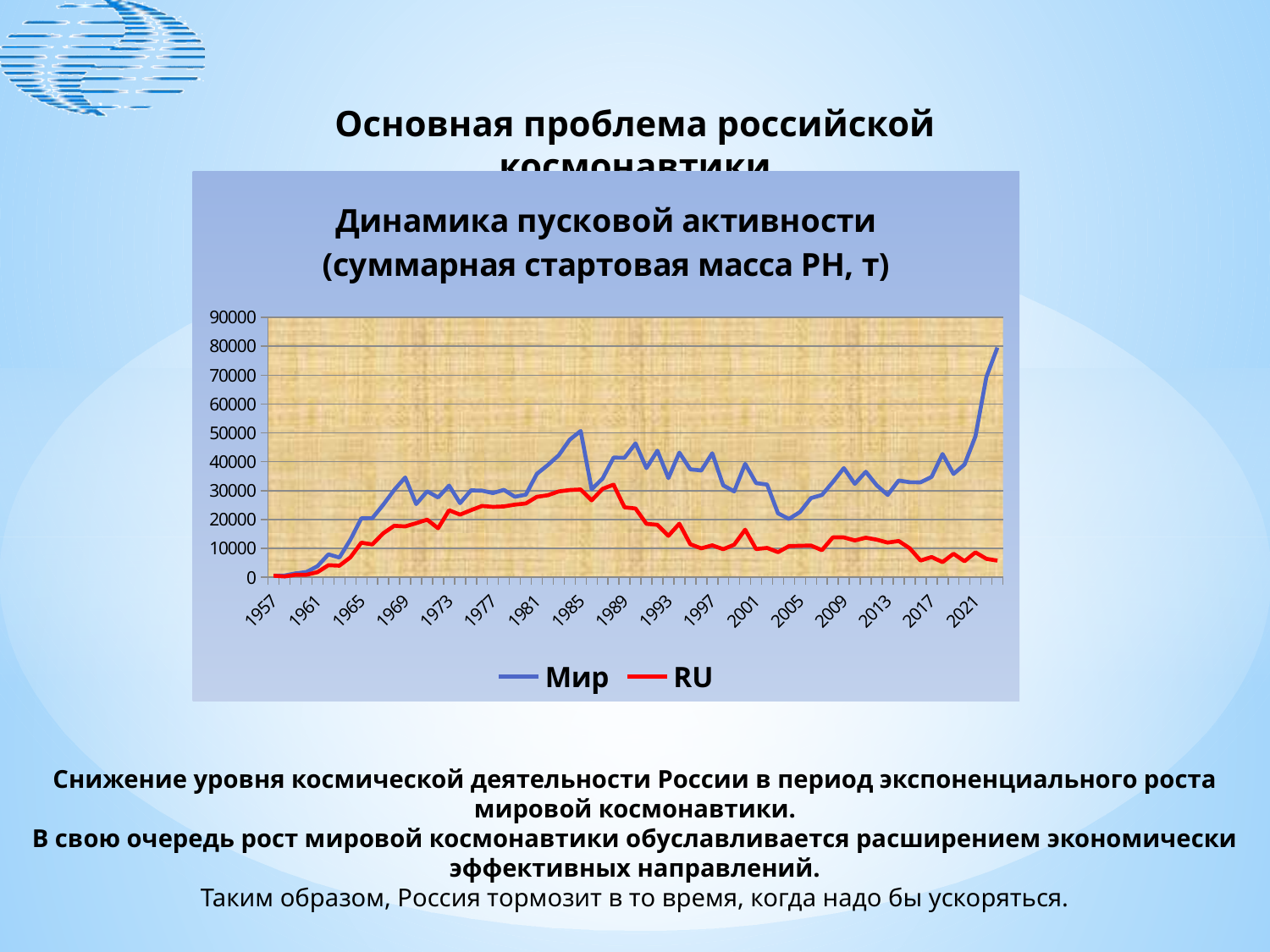
Which series has the larger value in 2013, Мир or RU? Мир What is the title of the chart? Динамика пусковой активности (суммарная стартовая масса РН, т) Is the value for RU in 1985 greater or less than 20000? greater What is the highest value shown on the y axis? 90000 What is the first year label on the x axis? 1957 Does the RU series rise or fall from 1989 to 2021? fall Is the value for RU in 2021 greater or less than 10000? less What are the two series named in the legend? Мир and RU Is the value for Мир in 1985 greater or less than 40000? greater How many series does the legend list? 2 Which series reaches the highest value on the chart? Мир What kind of chart is shown on the slide? line chart